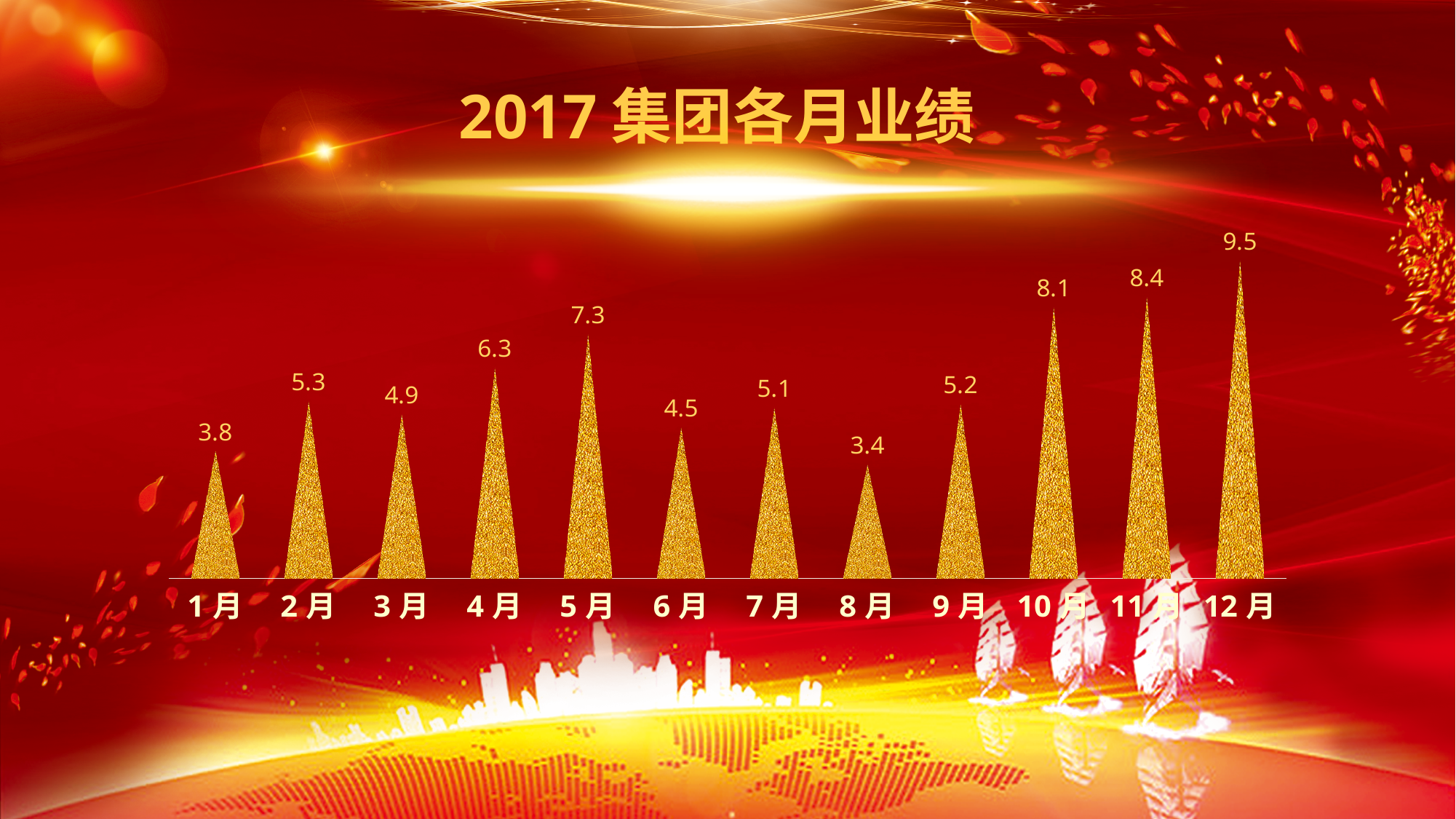
What is the value for 1月? 3.8 Which month has the lowest value? 8月 What is the difference between the values for 4月 and 3月? 1.4 Which is larger, the value for 2月 or the value for 6月? 2月 How many months are shown on the chart? 12 Which month has the highest value? 12月 What is the value for 5月? 7.3 What is the title of the chart? 2017 集团各月业绩 Which is larger, the value for 9月 or the value for 7月? 9月 What is the difference between the values for 12月 and 11月? 1.1 What is the value for 10月? 8.1 What kind of chart is shown on the slide? Bar chart